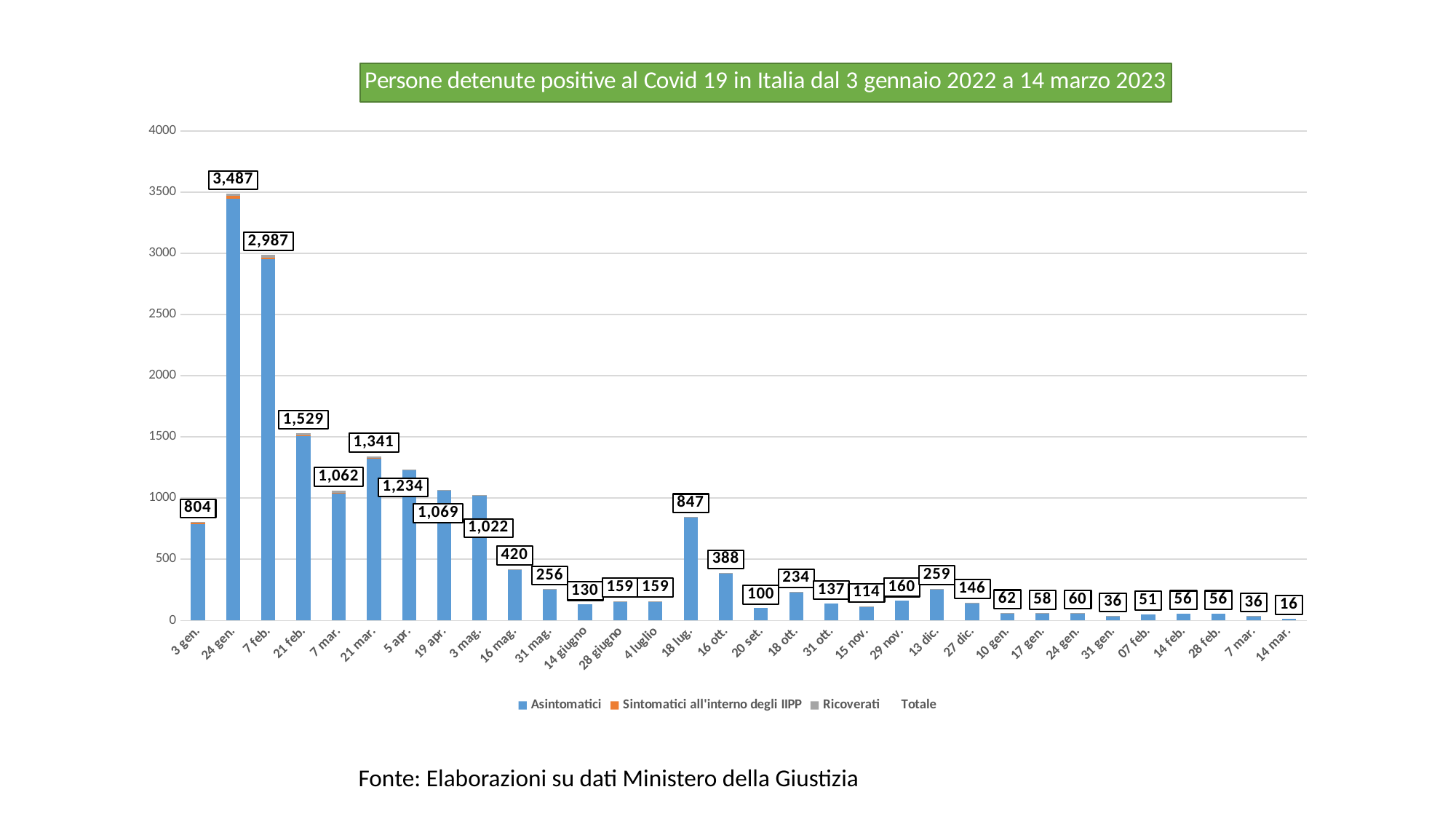
What is the total value shown for 18 lug.? 847 Do the totals rise or fall from 24 gen. to 3 mag.? Fall What is the difference between the totals for 24 gen. and 7 feb.? 500 How many series does the legend list? 4 How many dates are shown on the x axis? 32 What kind of chart is shown on the slide? Bar chart What is the total value shown for 14 mar.? 16 Which date has the lowest total of positive detainees? 14 mar. Which is larger, the total for 18 lug. or the total for 16 ott.? 18 lug. Is the value for 21 mar. greater or less than 1000? greater Which date has the highest total of positive detainees? 24 gen.